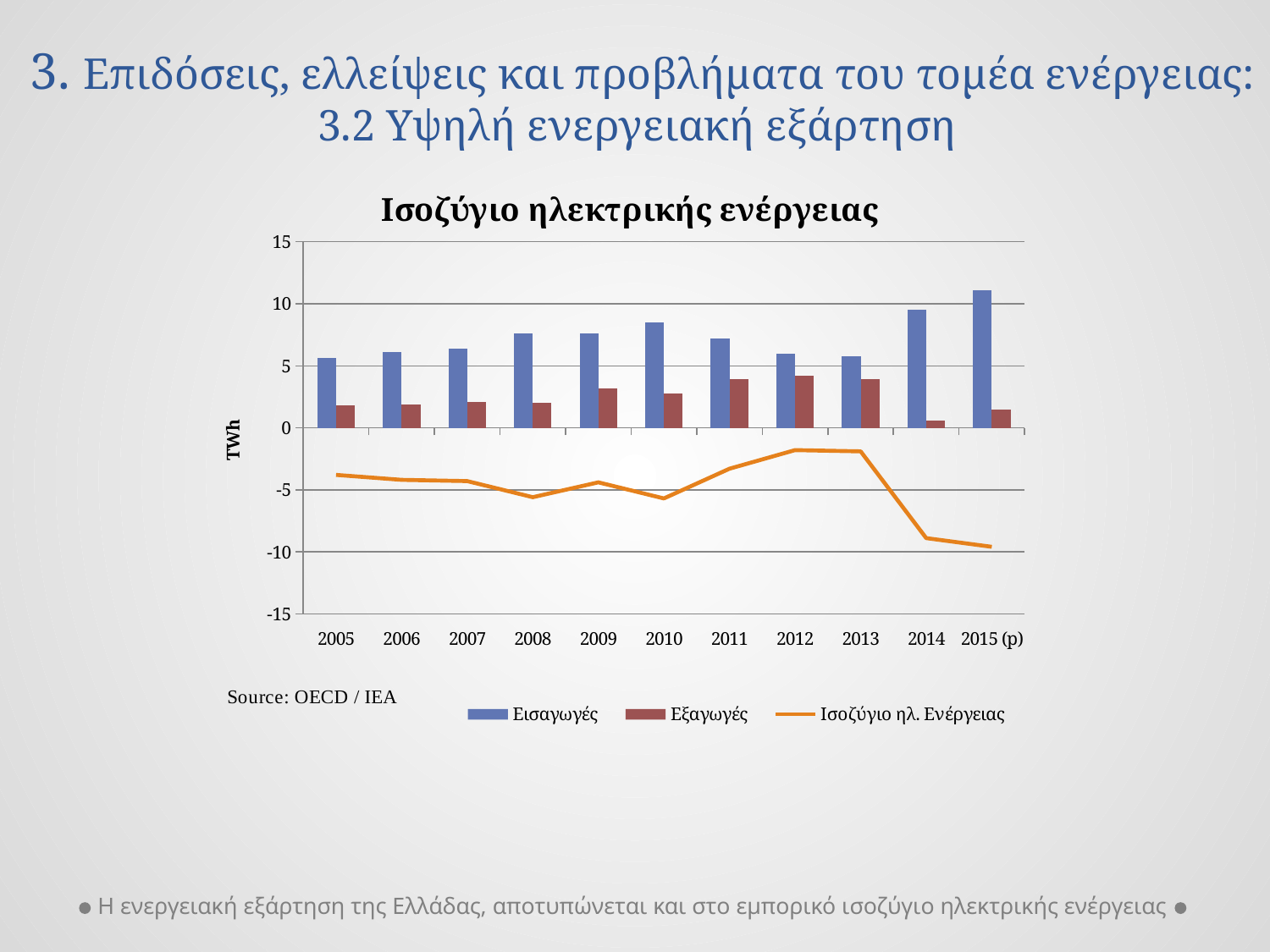
Is the value of Εξαγωγές for 2009 greater or less than 5? less In which year are the Εισαγωγές (imports) highest? 2015 (p) Which year has the larger Εισαγωγές value, 2010 or 2011? 2010 How many series does the chart legend list? 3 What kind of chart is shown on the slide? A combined bar and line chart How many years (categories) are shown on the x axis of the chart? 11 Is the value of Εισαγωγές for 2015 (p) greater or less than 10? greater What is the label on the vertical axis of the chart? TWh Is the value of Ισοζύγιο ηλ. Ενέργειας for 2014 greater or less than -5? less In which year are the Εξαγωγές (exports) lowest? 2014 Does the Ισοζύγιο ηλ. Ενέργειας line rise or fall from 2013 to 2015 (p)? It falls